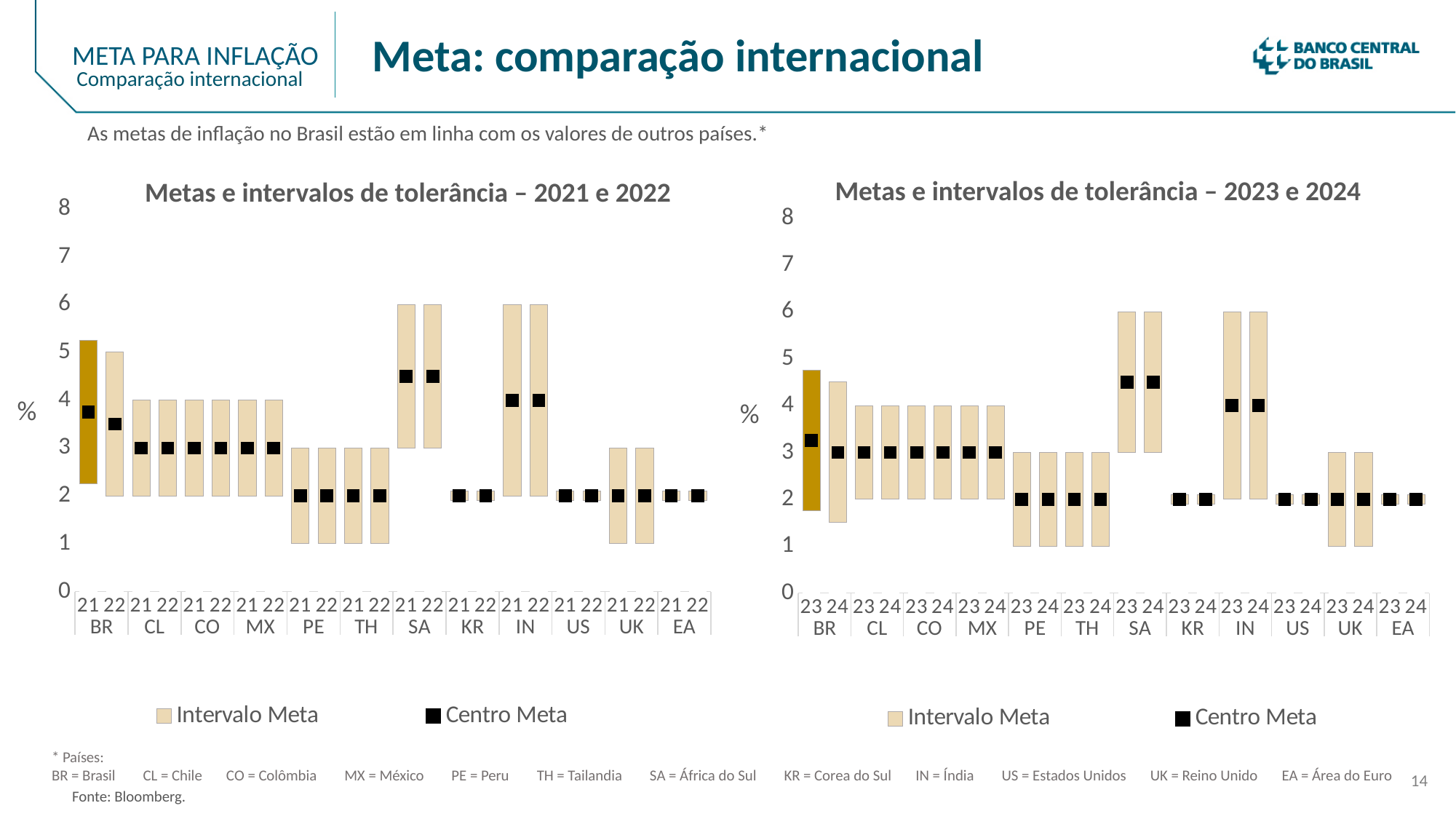
In the right chart ('2023 e 2024'), what is the Centro Meta for IN in 23? 4 How many series does the legend of the right chart ('2023 e 2024') list? 2 In the left chart ('2021 e 2022'), which country has the highest Centro Meta? SA In the left chart ('2021 e 2022'), which is larger: the Centro Meta for SA in 21 or for CL in 21? SA in 21 In the right chart ('2023 e 2024'), what is the difference between the Centro Meta for IN in 23 and for CL in 23? 1 In the left chart ('2021 e 2022'), what is the Centro Meta for CL in 21? 3 In the left chart ('2021 e 2022'), does the Centro Meta for BR rise or fall from 21 to 22? fall In the left chart ('2021 e 2022'), is the Centro Meta for BR in 21 greater or less than 3? greater In the right chart ('2023 e 2024'), is the lower end of the Intervalo Meta for BR in 24 greater or less than 2? less How many countries are shown on the x axis of the left chart ('2021 e 2022')? 12 What kind of chart is 'Metas e intervalos de tolerância – 2021 e 2022'? bar chart What is the title of the right chart? Metas e intervalos de tolerância – 2023 e 2024